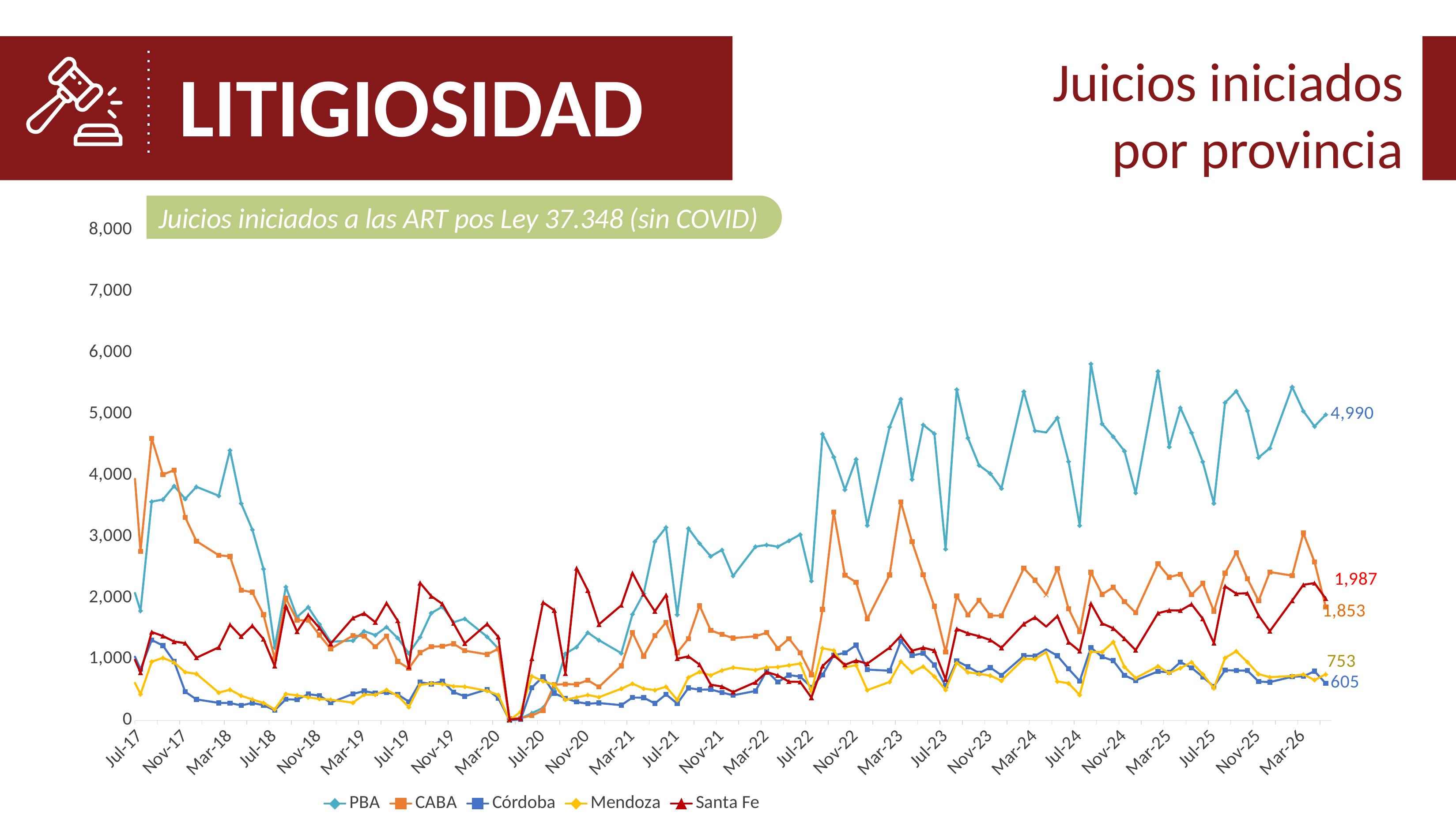
How many series does the legend list? 5 What is the final labelled value for the Mendoza series? 753 What is the final labelled value for the CABA series? 1,853 What is the final labelled value for the Córdoba series? 605 Which province has the highest final labelled value? PBA What kind of chart is shown on the slide? Line chart Which province has the lowest final labelled value? Córdoba What is the final labelled value for the PBA series? 4,990 Which has the larger final labelled value, Santa Fe or CABA? Santa Fe What is the final labelled value for the Santa Fe series? 1,987 What is the difference between the final labelled values of PBA and Santa Fe? 3,003